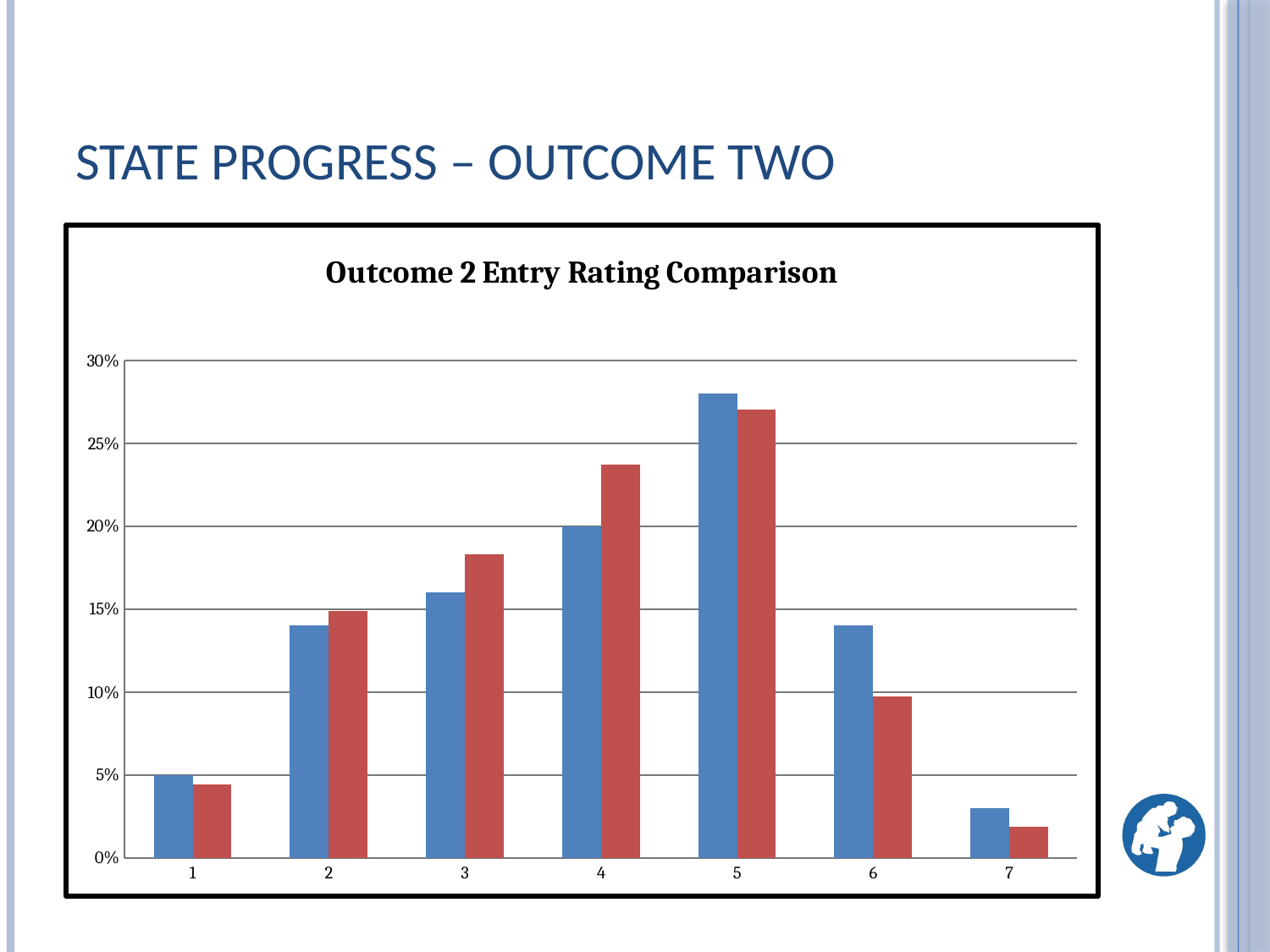
For category 4, which bar is taller, the blue bar or the red bar? red bar How many categories are shown on the x axis of the chart? 7 What type of chart is shown on the slide? bar chart Is the value of the blue bar for category 2 greater or less than 15%? less Which category has the lowest red bar? 7 Which category has the highest blue bar? 5 Is the value of the red bar for category 4 greater or less than 20%? greater Is the value of the blue bar for category 5 greater or less than 25%? greater Do the blue bars rise or fall from category 5 to category 7? fall What is the title of the chart? Outcome 2 Entry Rating Comparison For category 6, which bar is taller, the blue bar or the red bar? blue bar